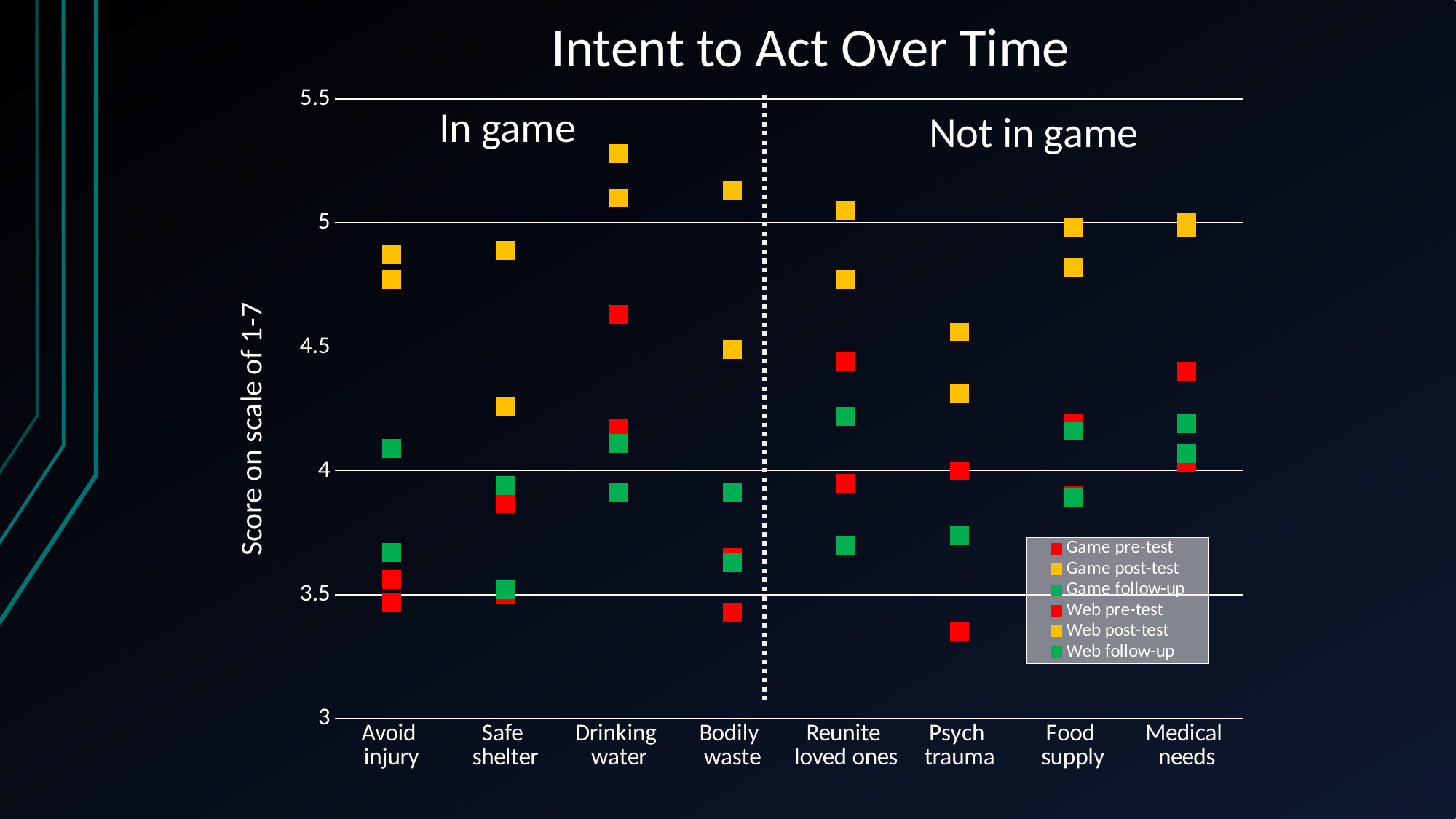
Are the yellow post-test points for Drinking water greater or less than 5? greater Is the lowest point for Psych trauma greater or less than 3.5? less Which category has the highest plotted point on the chart? Drinking water What kind of chart is shown on the slide? scatter chart Are the red pre-test points for Avoid injury greater or less than 4? less How many series does the legend list? 6 Is the highest point for Drinking water higher or lower than the highest point for Safe shelter? higher Which category has the lowest plotted point on the chart? Psych trauma What is the title of the chart? Intent to Act Over Time What is the label on the vertical axis? Score on scale of 1-7 How many categories are shown along the x axis? 8